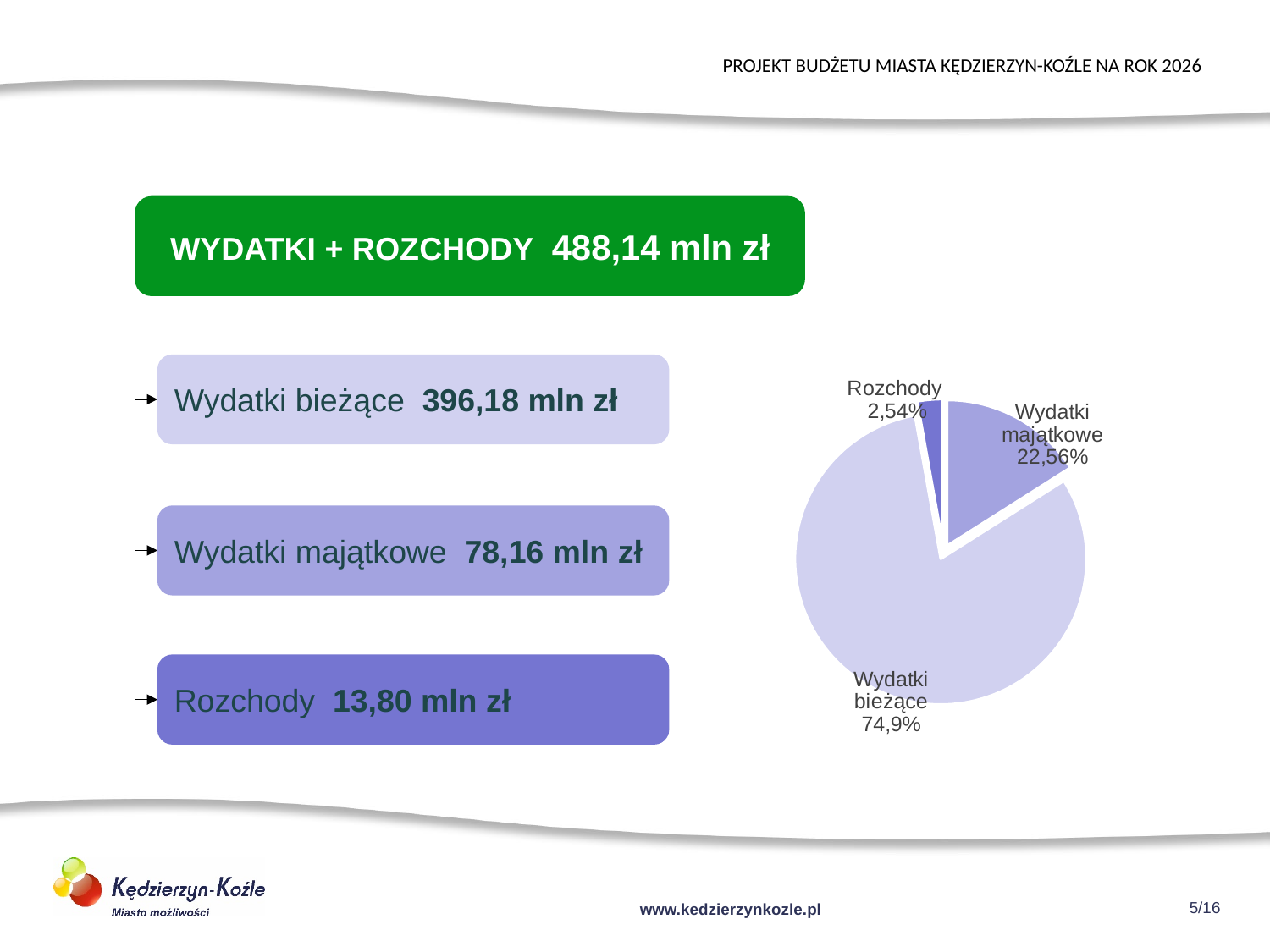
Which slice of the pie chart is drawn in the darkest shade of purple? Rozchody By how many percentage points does the Wydatki majątkowe share exceed the Rozchody share in the pie chart? 20,02 What share of the pie chart is Rozchody? 2,54% How many slices does the pie chart have? 3 What share of the pie chart is Wydatki bieżące? 74,9% Which slice of the pie chart is the largest? Wydatki bieżące By how many percentage points does the Wydatki bieżące share exceed the Wydatki majątkowe share in the pie chart? 52,34 What kind of chart is shown on the slide? pie chart Which slice of the pie chart is drawn in the lightest shade? Wydatki bieżące Which is larger in the pie chart, Wydatki majątkowe or Rozchody? Wydatki majątkowe Which slice of the pie chart is the smallest? Rozchody What share of the pie chart is Wydatki majątkowe? 22,56%